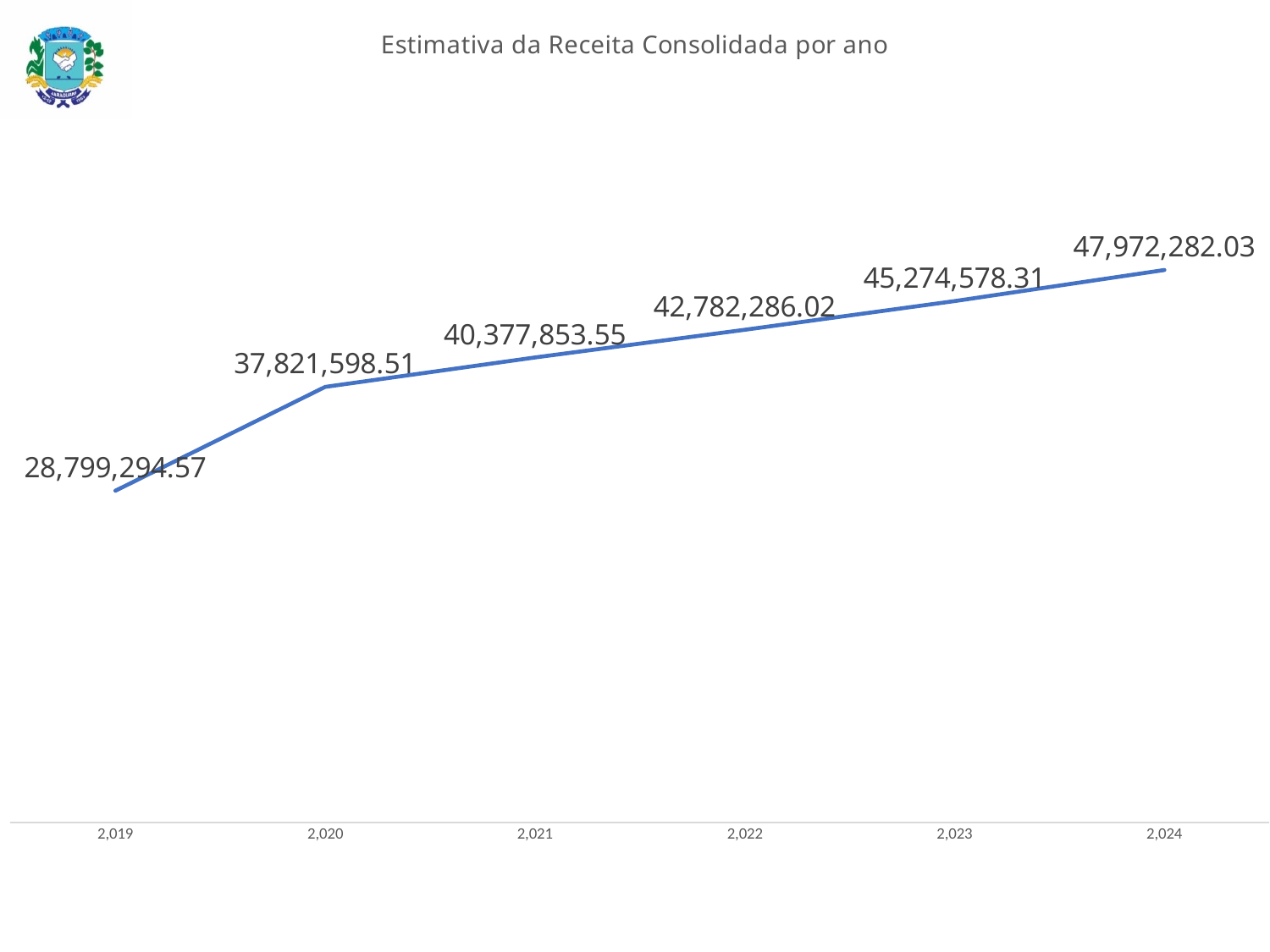
Which year has the highest value in the chart? 2,024 What is the difference between the values for 2,024 and 2,023? 2,697,703.72 What is the difference between the values for 2,020 and 2,019? 9,022,303.94 Do the values rise or fall from 2,019 to 2,024? Rise How many years are plotted on the x axis of the chart? 6 What kind of chart is shown on the slide? Line chart What is the value for 2,019 in the chart? 28,799,294.57 What is the value for 2,024 in the chart? 47,972,282.03 Which year has the lowest value in the chart? 2,019 Which is larger, the value for 2,022 or the value for 2,021? 2,022 What is the value for 2,023 in the chart? 45,274,578.31 What is the value for 2,021 in the chart? 40,377,853.55